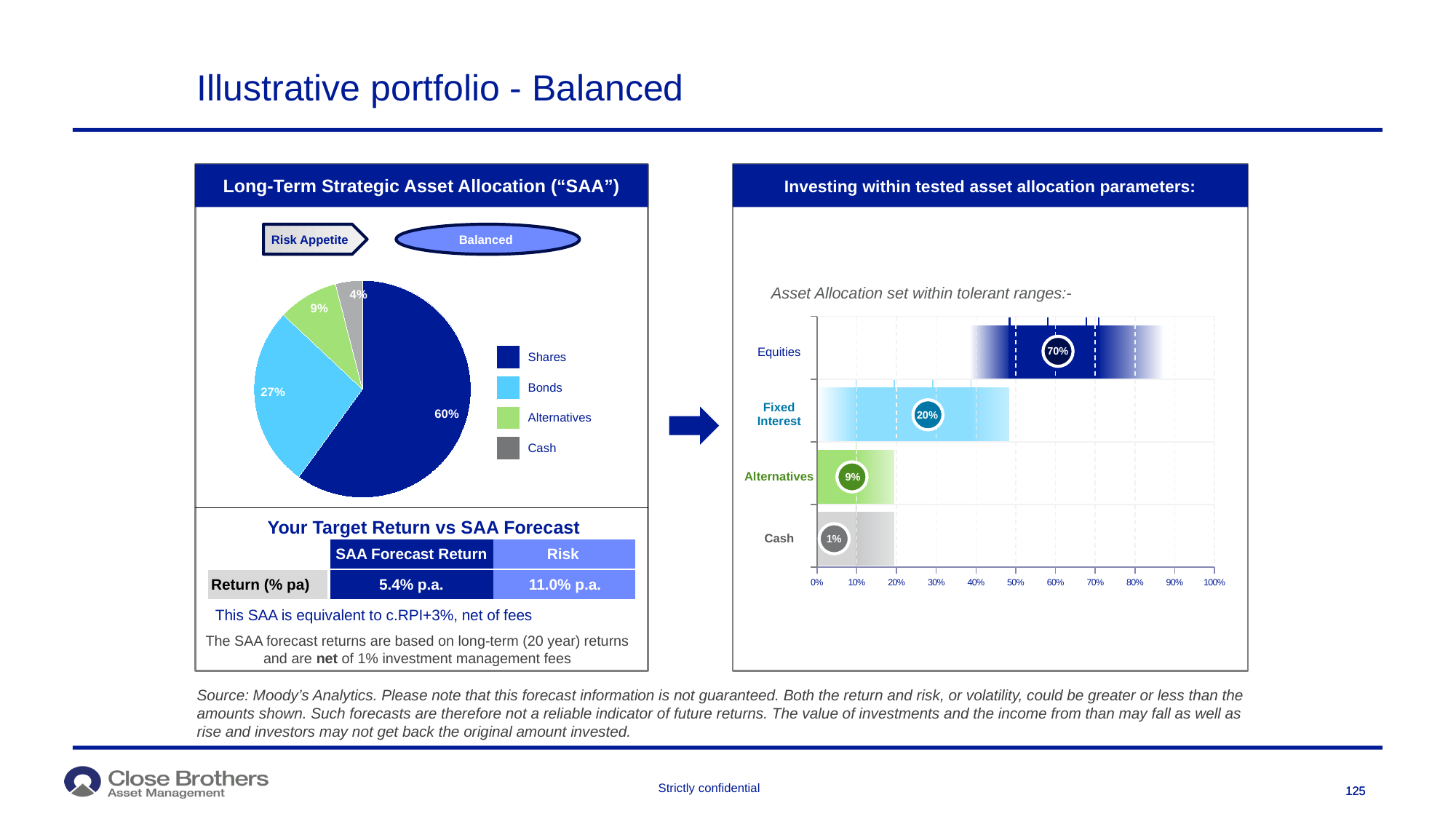
In the chart under "Investing within tested asset allocation parameters", what is the value marked for Fixed Interest? 20% In the pie chart under "Long-Term Strategic Asset Allocation", which asset class has the smallest slice? Cash What kind of chart is shown under "Long-Term Strategic Asset Allocation"? Pie chart In the chart under "Investing within tested asset allocation parameters", what is the value marked for Equities? 70% In the pie chart under "Long-Term Strategic Asset Allocation", what percentage is allocated to Bonds? 27% In the pie chart under "Long-Term Strategic Asset Allocation", how many percentage points larger is the Shares slice than the Bonds slice? 33 How many slices does the pie chart under "Long-Term Strategic Asset Allocation" have? 4 In the pie chart under "Long-Term Strategic Asset Allocation", what percentage is allocated to Shares? 60% What kind of chart is shown under "Investing within tested asset allocation parameters"? Bar chart In the chart under "Investing within tested asset allocation parameters", which category has the lowest marked value? Cash In the pie chart under "Long-Term Strategic Asset Allocation", which asset class has the largest slice? Shares In the chart under "Investing within tested asset allocation parameters", which has the larger marked value, Fixed Interest or Alternatives? Fixed Interest